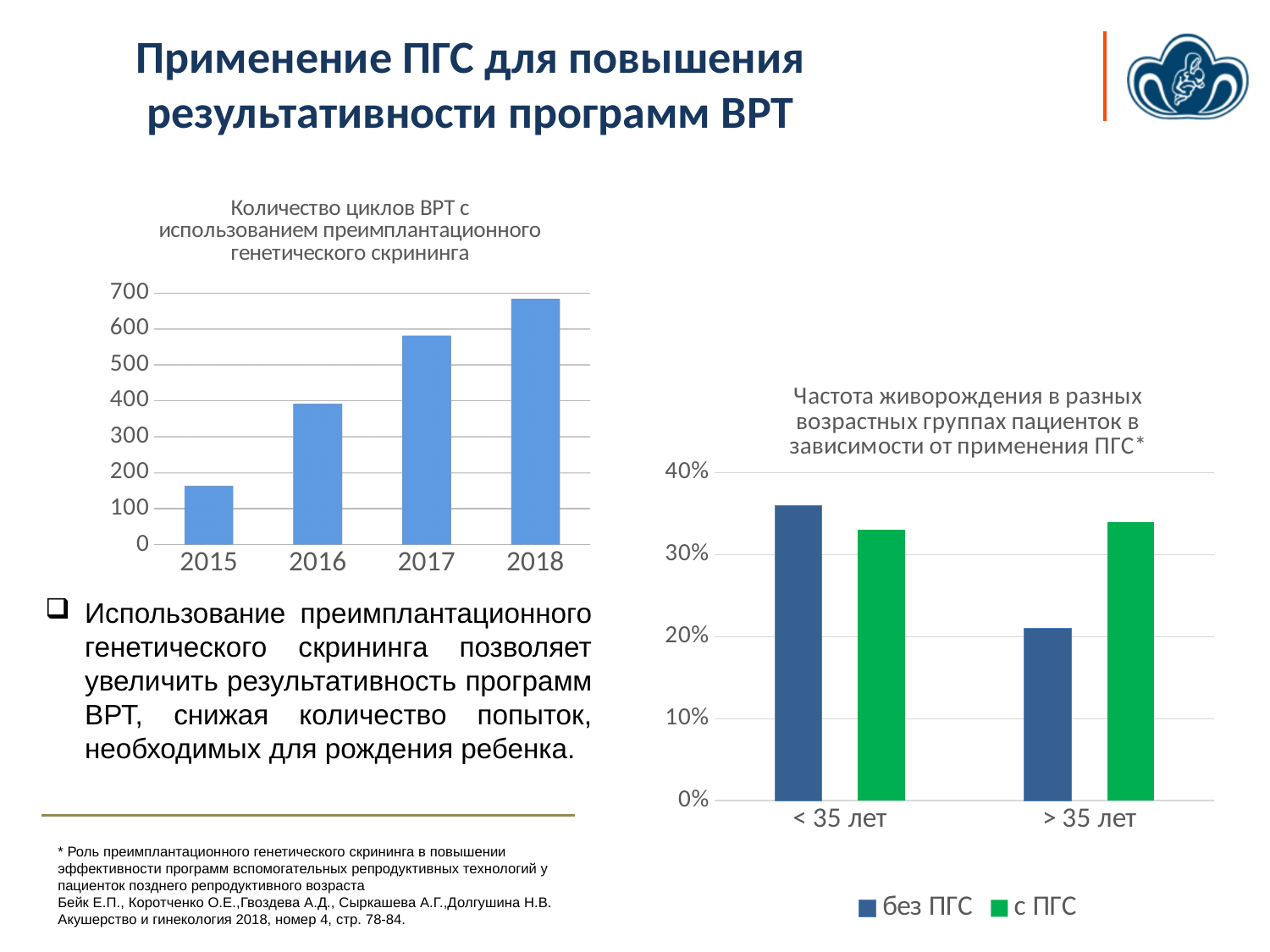
In the left chart, 'Количество циклов ВРТ с использованием преимплантационного генетического скрининга', is the value for 2016 greater or less than 300? greater In the right chart, 'Частота живорождения в разных возрастных группах пациенток в зависимости от применения ПГС*', is the 'без ПГС' value for '> 35 лет' greater or less than 30%? less How many years are shown on the x axis of the left chart, 'Количество циклов ВРТ с использованием преимплантационного генетического скрининга'? 4 In the right chart, 'Частота живорождения в разных возрастных группах пациенток в зависимости от применения ПГС*', is the 'без ПГС' value for '< 35 лет' greater or less than 30%? greater In the left chart, 'Количество циклов ВРТ с использованием преимплантационного генетического скрининга', do the values rise or fall from 2015 to 2018? rise In the left chart, 'Количество циклов ВРТ с использованием преимплантационного генетического скрининга', which year has the highest value? 2018 In the right chart, 'Частота живорождения в разных возрастных группах пациенток в зависимости от применения ПГС*', which is larger for the '> 35 лет' group: 'без ПГС' or 'с ПГС'? с ПГС What kind of chart is the left chart, 'Количество циклов ВРТ с использованием преимплантационного генетического скрининга'? bar chart In the right chart, 'Частота живорождения в разных возрастных группах пациенток в зависимости от применения ПГС*', what colour are the 'с ПГС' bars? green In the left chart, 'Количество циклов ВРТ с использованием преимплантационного генетического скрининга', which year has the lowest value? 2015 How many series does the legend of the right chart, 'Частота живорождения в разных возрастных группах пациенток в зависимости от применения ПГС*', list? 2